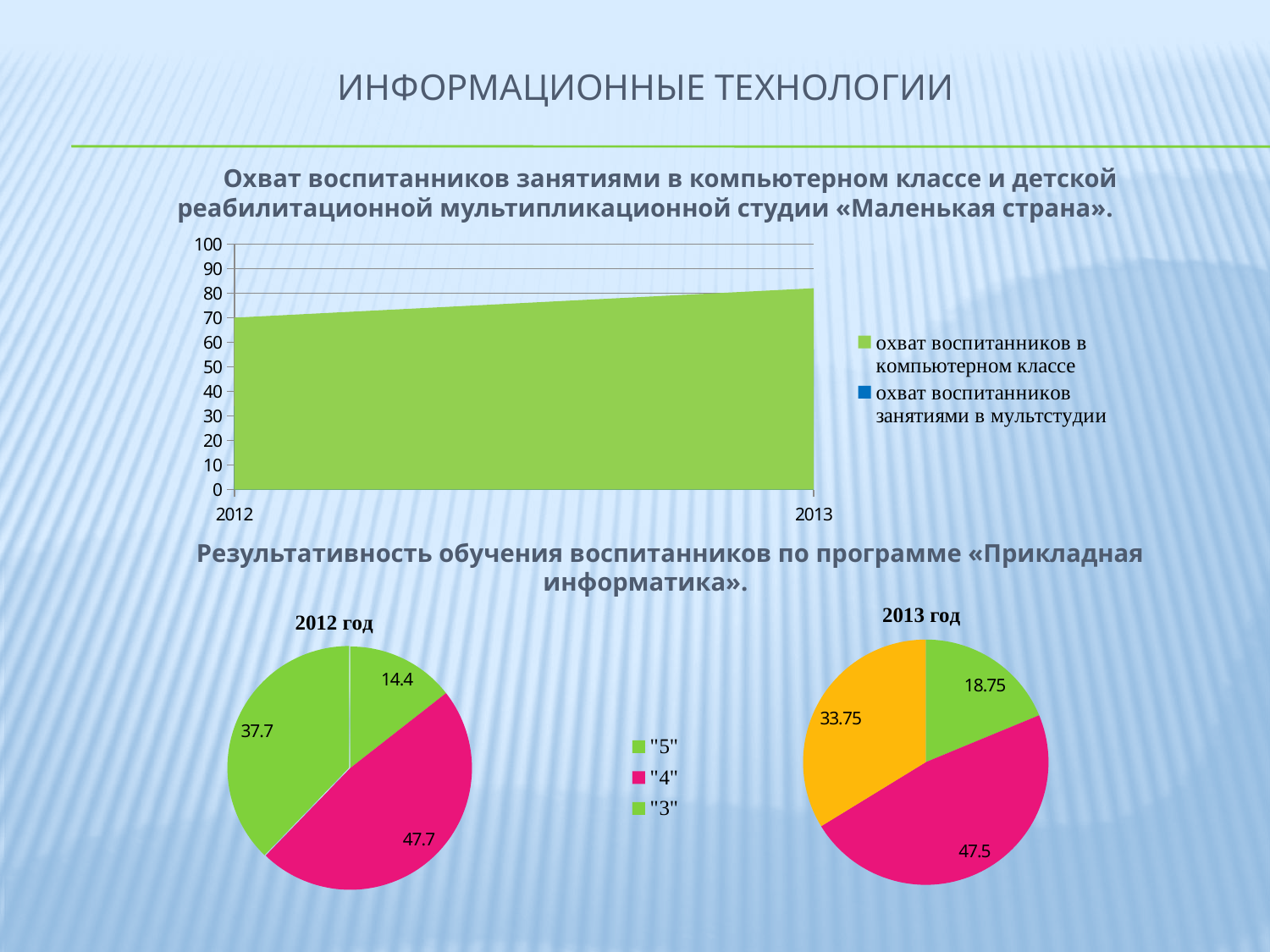
In the top area chart, is the value for 2012 greater or less than 60? greater In the pie chart titled "2013 год", what is the value of the pink slice ("4")? 47.5 What entries does the legend shared by the two pie charts list? "5", "4", "3" How many slices does the pie chart titled "2013 год" have? 3 In the pie chart titled "2012 год", what is the value of the smallest slice? 14.4 In the pie chart titled "2012 год", what is the difference between the largest and smallest slice values? 33.3 In the pie chart titled "2012 год", what is the value of the largest slice? 47.7 In the top area chart, does the value rise or fall from 2012 to 2013? rises What kind of chart is the top chart on the slide (the one with years 2012 and 2013 on the x axis)? area chart In the top area chart, is the value for 2013 greater or less than 90? less In the pie chart titled "2013 год", what is the difference between the 47.5 slice and the 18.75 slice? 28.75 How many series does the legend of the top area chart list? 2